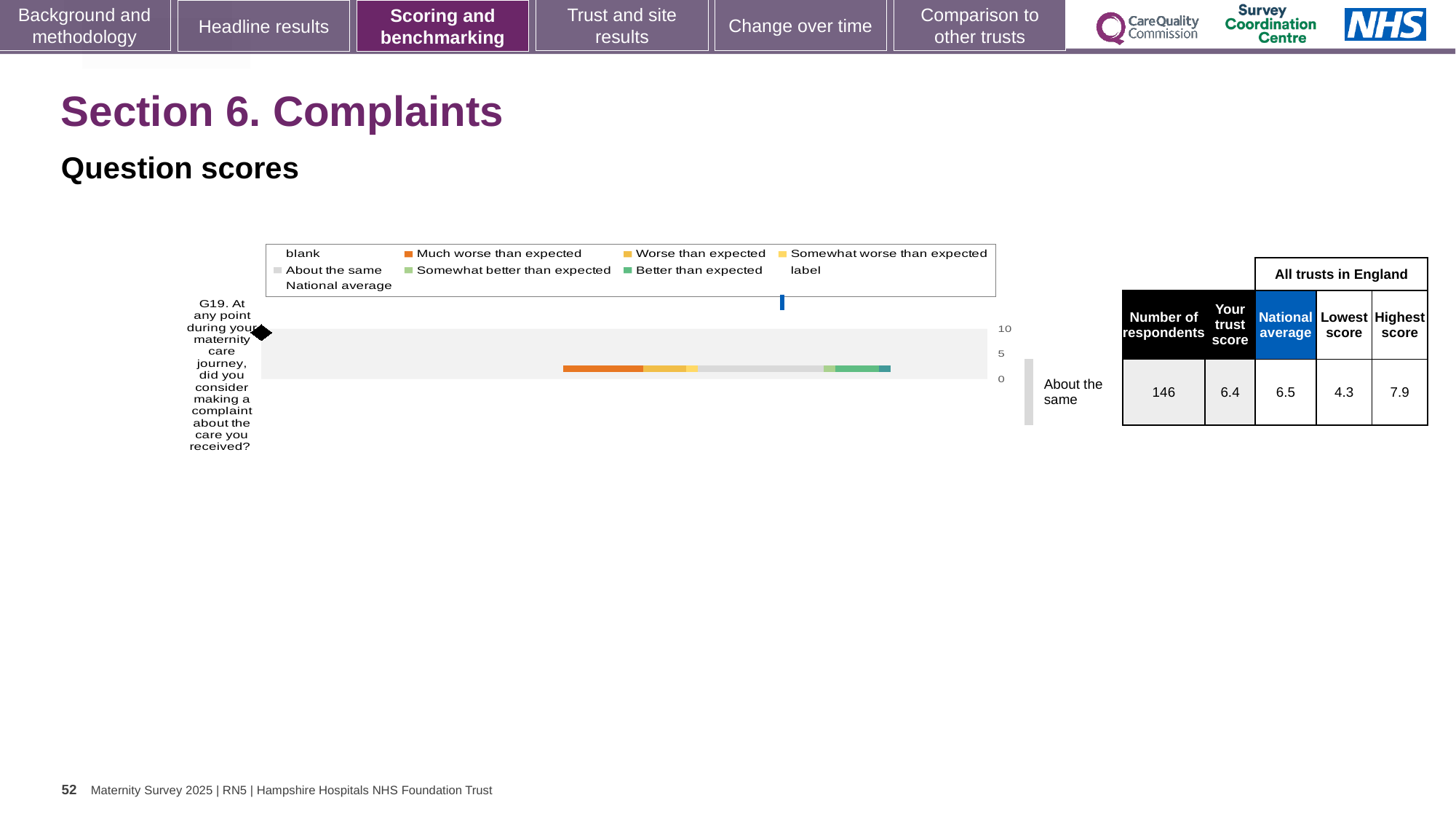
What is the national average for question G19? 6.5 How many survey questions are plotted in the chart? 1 What is the trust score for question G19? 6.4 Which benchmark category is shown for question G19? About the same What is the lowest score among all trusts in England for question G19? 4.3 Which is larger for question G19, the trust score or the national average? National average What is the highest score among all trusts in England for question G19? 7.9 Which question is plotted in the chart? G19. At any point during your maternity care journey, did you consider making a complaint about the care you received? What is the difference between the highest score and the lowest score for question G19? 3.6 What kind of chart is shown on the slide? bar chart What colour does the legend use for 'Much worse than expected'? Orange How many respondents answered question G19? 146